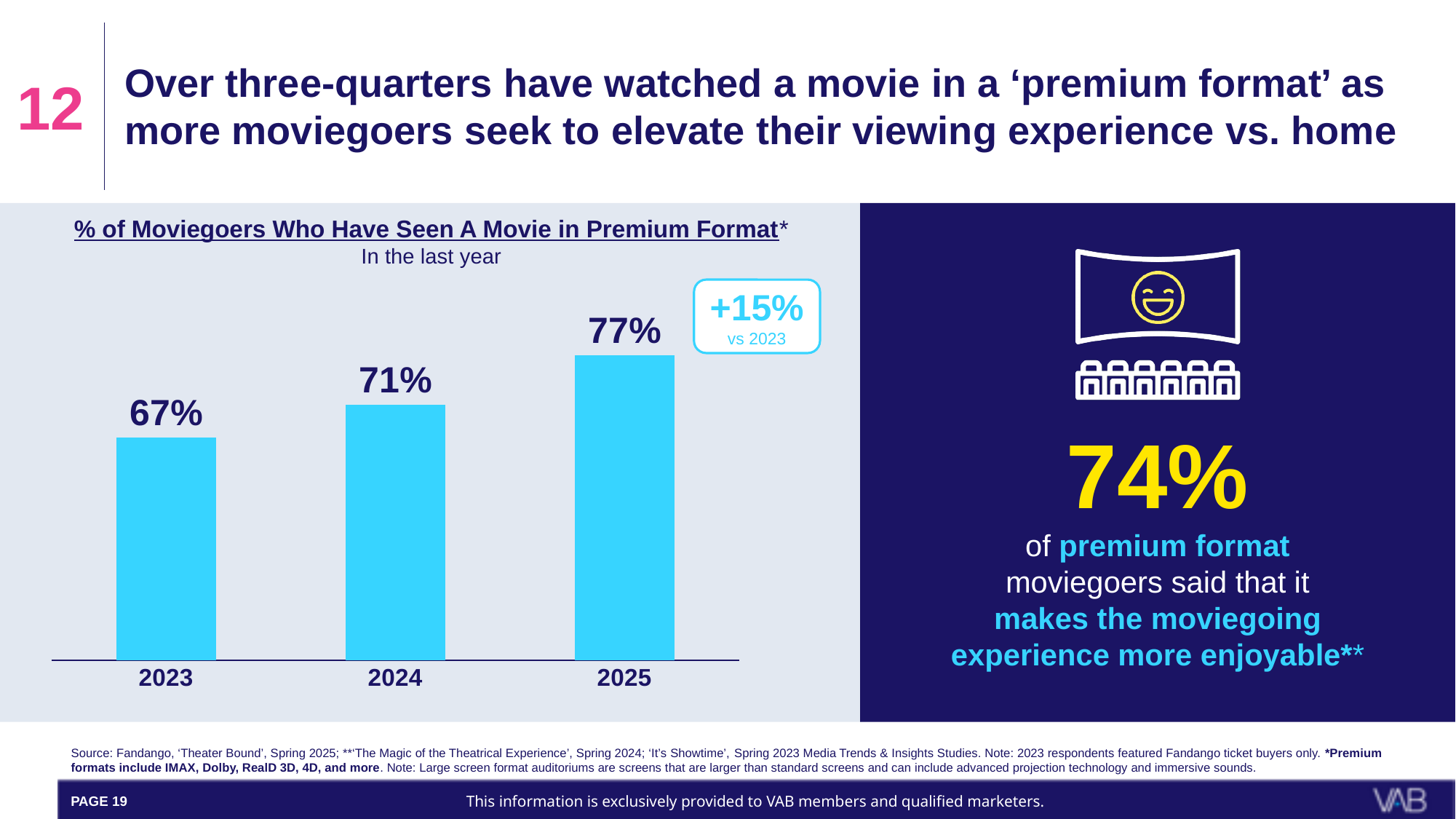
Which year has a larger value, 2024 or 2025? 2025 What percentage of moviegoers had seen a movie in premium format in 2024? 71% What is the difference in percentage points between 2024 and 2023? 4 Which year has the lowest percentage of moviegoers who have seen a movie in premium format? 2023 What percentage of moviegoers had seen a movie in premium format in 2023? 67% What percentage of moviegoers had seen a movie in premium format in 2025? 77% Which year has the highest percentage of moviegoers who have seen a movie in premium format? 2025 What is the difference in percentage points between 2025 and 2023? 10 Do the values rise or fall from 2023 to 2025? Rise What kind of chart is shown on the slide? Bar chart What is the title of the chart? % of Moviegoers Who Have Seen A Movie in Premium Format How many years are shown in the chart? 3